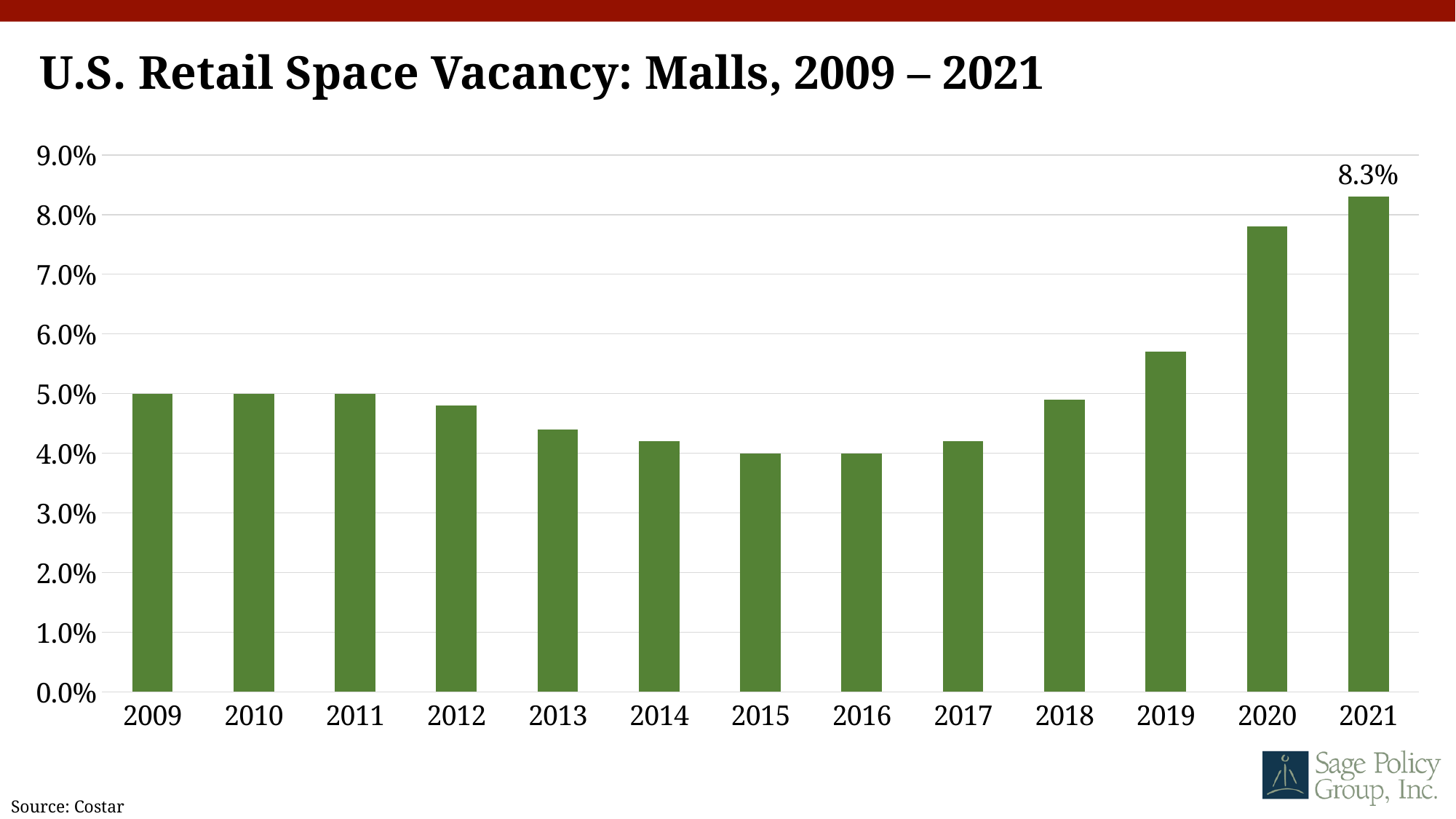
Which year has the larger vacancy rate, 2019 or 2020? 2020 Do the vacancy rates rise or fall from 2016 to 2021? Rise What source is cited for the chart data? Costar Is the value for 2013 greater or less than 5.0%? less What is the mall vacancy rate shown for 2021? 8.3% Is the value for 2019 greater or less than 6.0%? less Which year has the larger vacancy rate, 2012 or 2015? 2012 How many years are plotted on the chart? 13 What kind of chart is shown on the slide? Bar chart What is the title of the chart? U.S. Retail Space Vacancy: Malls, 2009 – 2021 Which year has the highest mall vacancy rate? 2021 Is the value for 2020 greater or less than 7.0%? greater